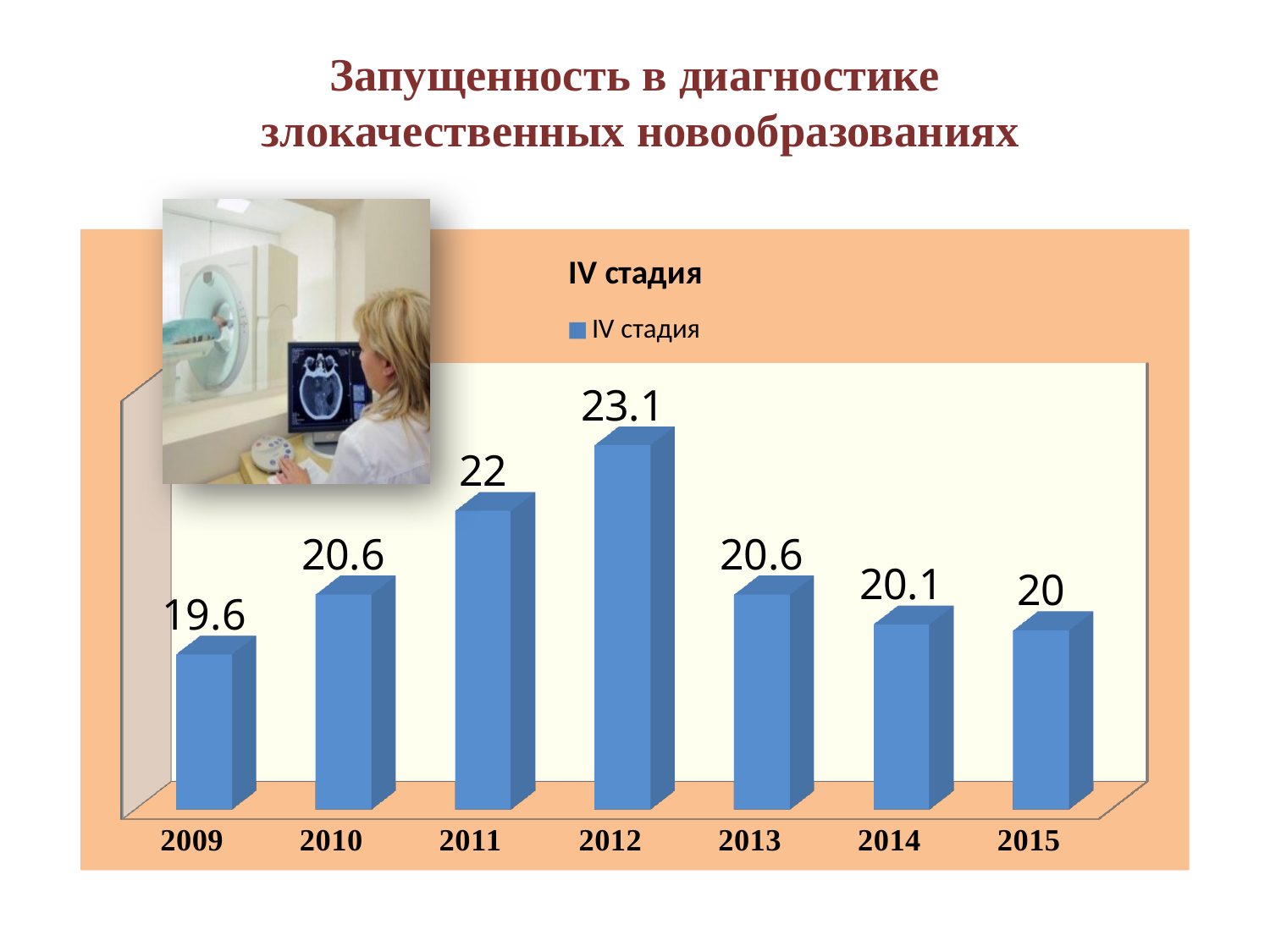
What is the difference between the values for 2012 and 2009? 3.5 Which year has the highest value? 2012 How many years are shown on the x axis? 7 What kind of chart is this? bar chart What is the value for 2009? 19.6 What is the value for 2012? 23.1 How many series does the legend list? 1 Which is larger, the value for 2011 or the value for 2013? 2011 What is the difference between the values for 2011 and 2014? 1.9 What is the title of the chart? IV стадия Which year has the lowest value? 2009 What is the value for 2015? 20